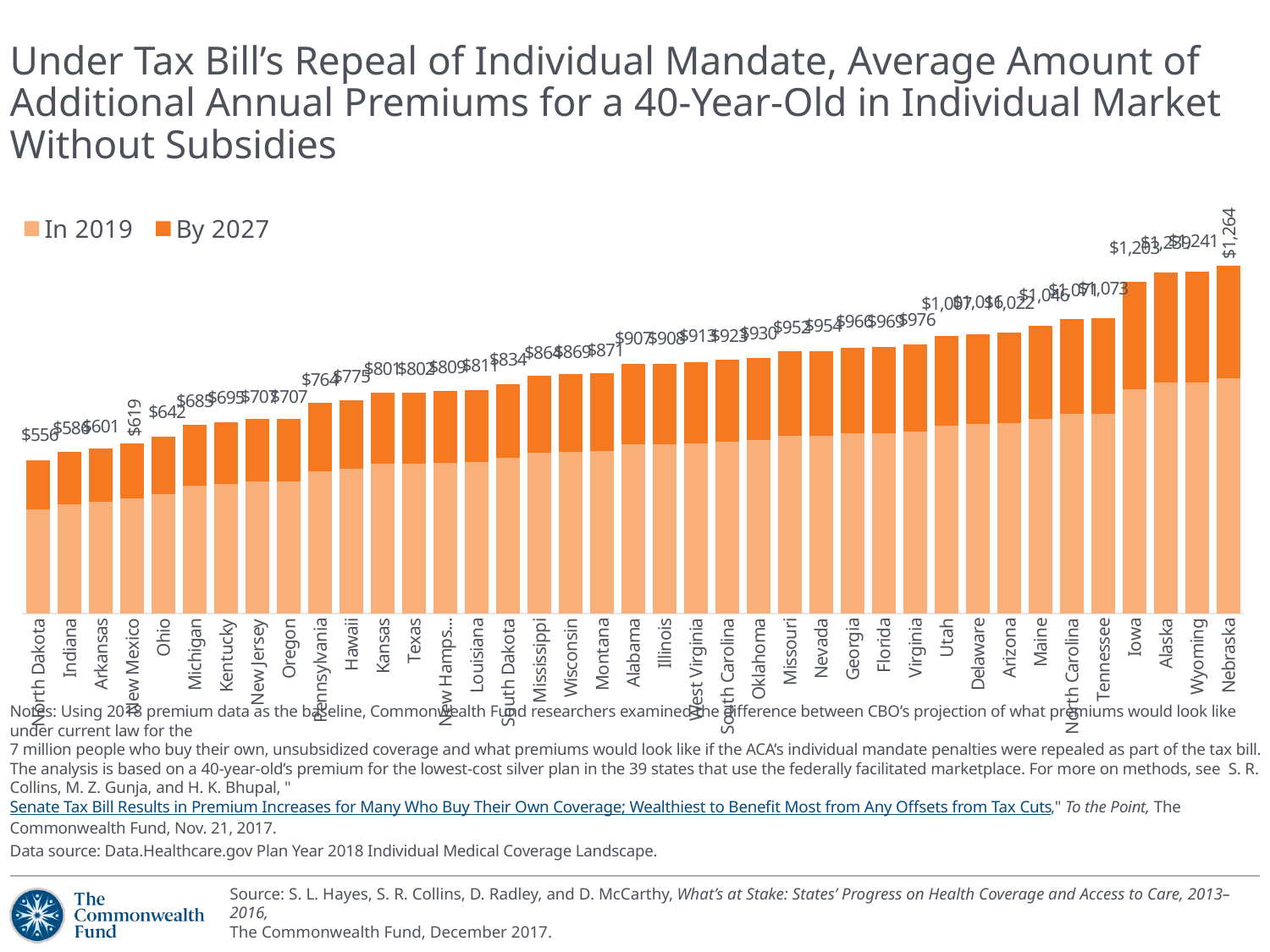
What value is labeled above the bar for Ohio? $642 How many states are shown along the x axis? 39 How many series does the legend list? 2 What kind of chart is shown on the slide? Stacked bar chart Which state has the lowest labeled value? North Dakota What value is labeled above the bar for Alabama? $907 What value is labeled above the bar for Pennsylvania? $764 Which state has the highest labeled value? Nebraska Do the labeled values rise or fall moving from left to right across the states? Rise What value is labeled above the bar for North Dakota? $556 What are the two series named in the legend? In 2019 and By 2027 What is the difference between the labeled values for Nebraska and North Dakota? $708